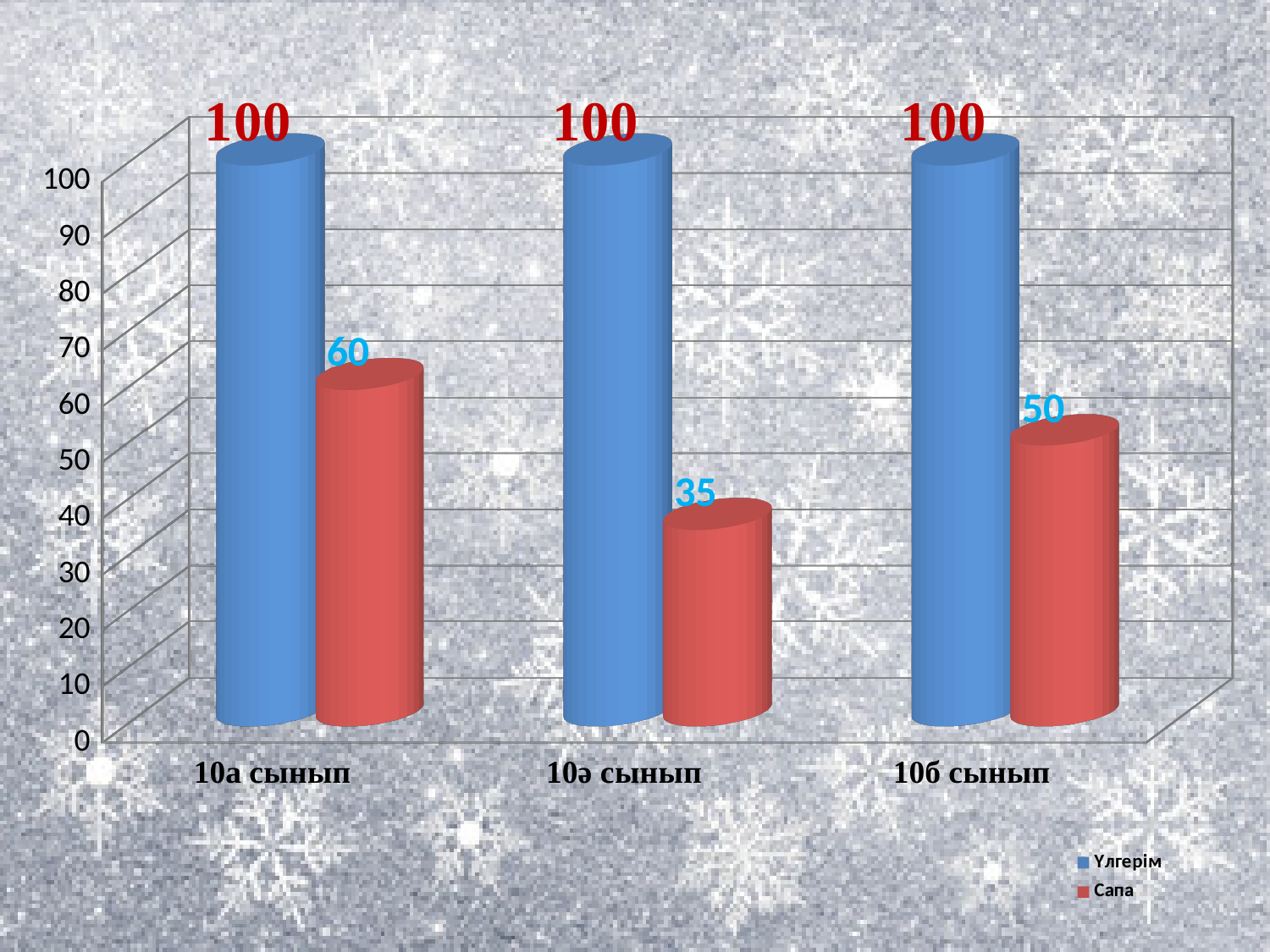
How many categories are shown on the x axis? 3 What is the Сапа value for 10ә сынып? 35 Which is larger, the Сапа value for 10б сынып or for 10ә сынып? 10б сынып What is the Сапа value for 10а сынып? 60 Which category has the highest Сапа value? 10а сынып Which category has the lowest Сапа value? 10ә сынып Which series is shown in red? Сапа What is the difference between the Үлгерім and Сапа values for 10б сынып? 50 What is the Үлгерім value for 10б сынып? 100 How many series does the legend list? 2 What is the difference between the Сапа values for 10а сынып and 10ә сынып? 25 What kind of chart is shown on the slide? Bar chart